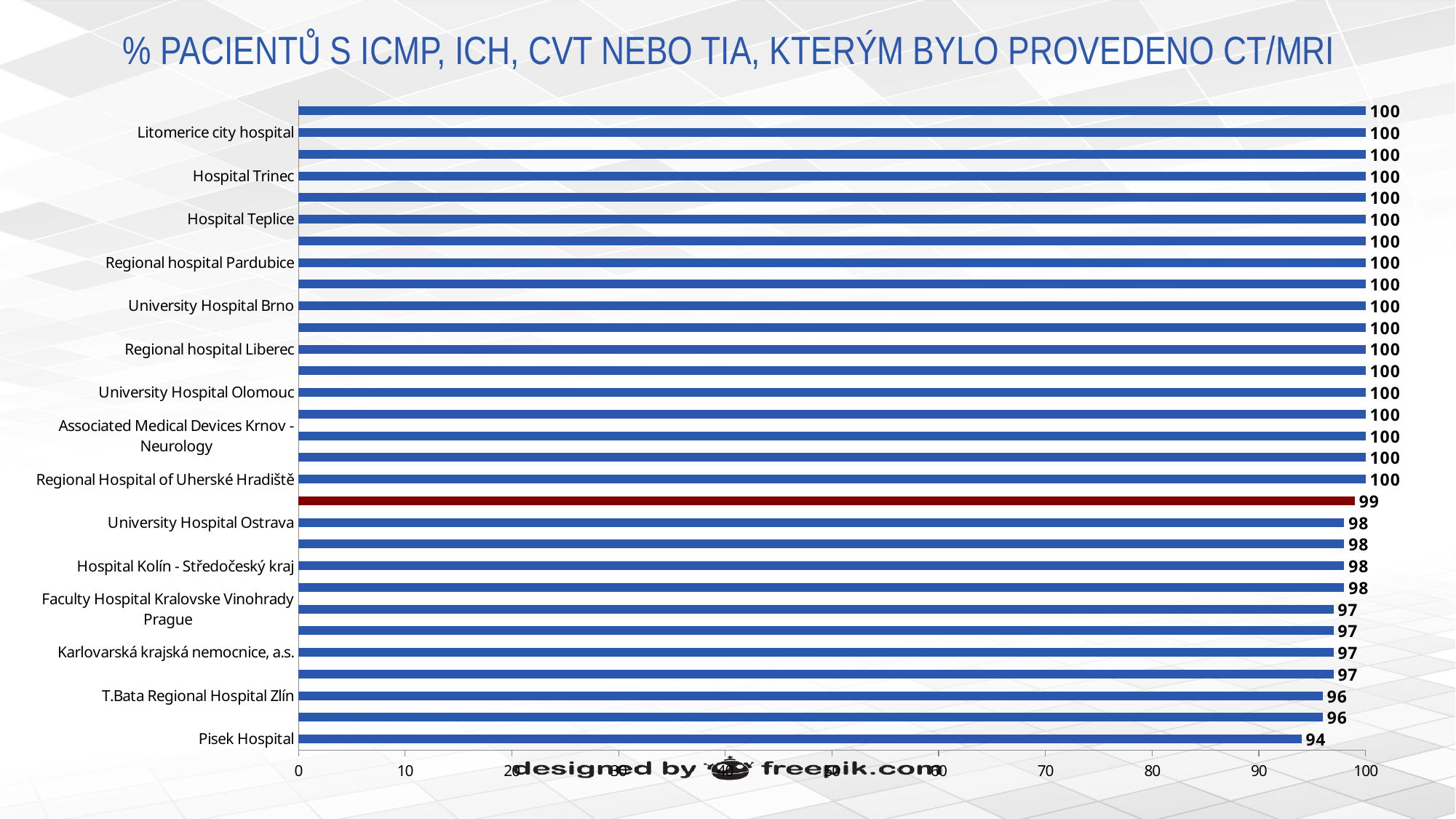
Is the value for Pisek Hospital greater or less than 90? greater What is the value for T.Bata Regional Hospital Zlín? 96 What type of chart is shown on the slide? bar chart What is the value for University Hospital Ostrava? 98 How many bars are plotted in the chart? 30 What is the value for Litomerice city hospital? 100 What is the difference between the values for University Hospital Ostrava and Pisek Hospital? 4 What is the value for Pisek Hospital? 94 What is the value of the bar highlighted in dark red? 99 What is the value for Faculty Hospital Kralovske Vinohrady Prague? 97 Which has a larger value, Hospital Kolín - Středočeský kraj or Karlovarská krajská nemocnice, a.s.? Hospital Kolín - Středočeský kraj Which hospital has the lowest value in the chart? Pisek Hospital